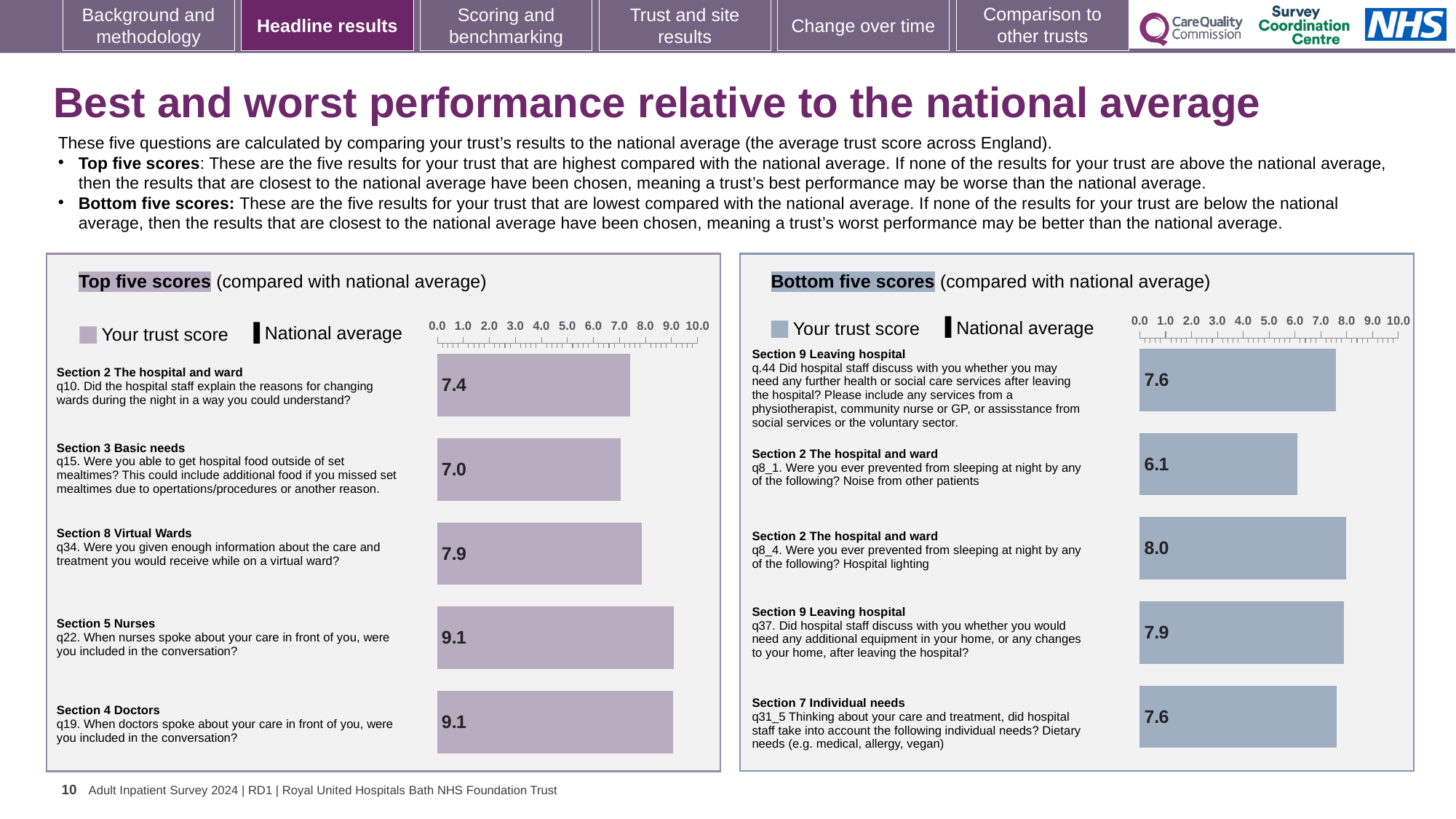
In the Top five scores chart, what is the difference between the trust score for q22 and the trust score for q34? 1.2 In the Top five scores chart, how many questions are plotted? 5 In the Top five scores chart, which question has the lowest trust score? q15 (hospital food outside of set mealtimes) In the Top five scores chart, what is the trust score for q15 (getting hospital food outside of set mealtimes)? 7.0 In the Top five scores chart, what is the trust score for q10 (explaining reasons for changing wards during the night)? 7.4 In the Bottom five scores chart, what is the trust score for q8_1 (noise from other patients)? 6.1 In the Bottom five scores chart, what is the difference between the trust score for q8_4 and the trust score for q8_1? 1.9 In the Bottom five scores chart, which question has the highest trust score? q8_4 (hospital lighting) In the Bottom five scores chart, what is the trust score for q37 (additional equipment or changes to your home)? 7.9 What type of chart is used in the Top five scores panel? Bar chart In the Bottom five scores chart, which is larger: the trust score for q44 or the trust score for q8_4? q8_4 In the Bottom five scores chart, which question has the lowest trust score? q8_1 (noise from other patients)